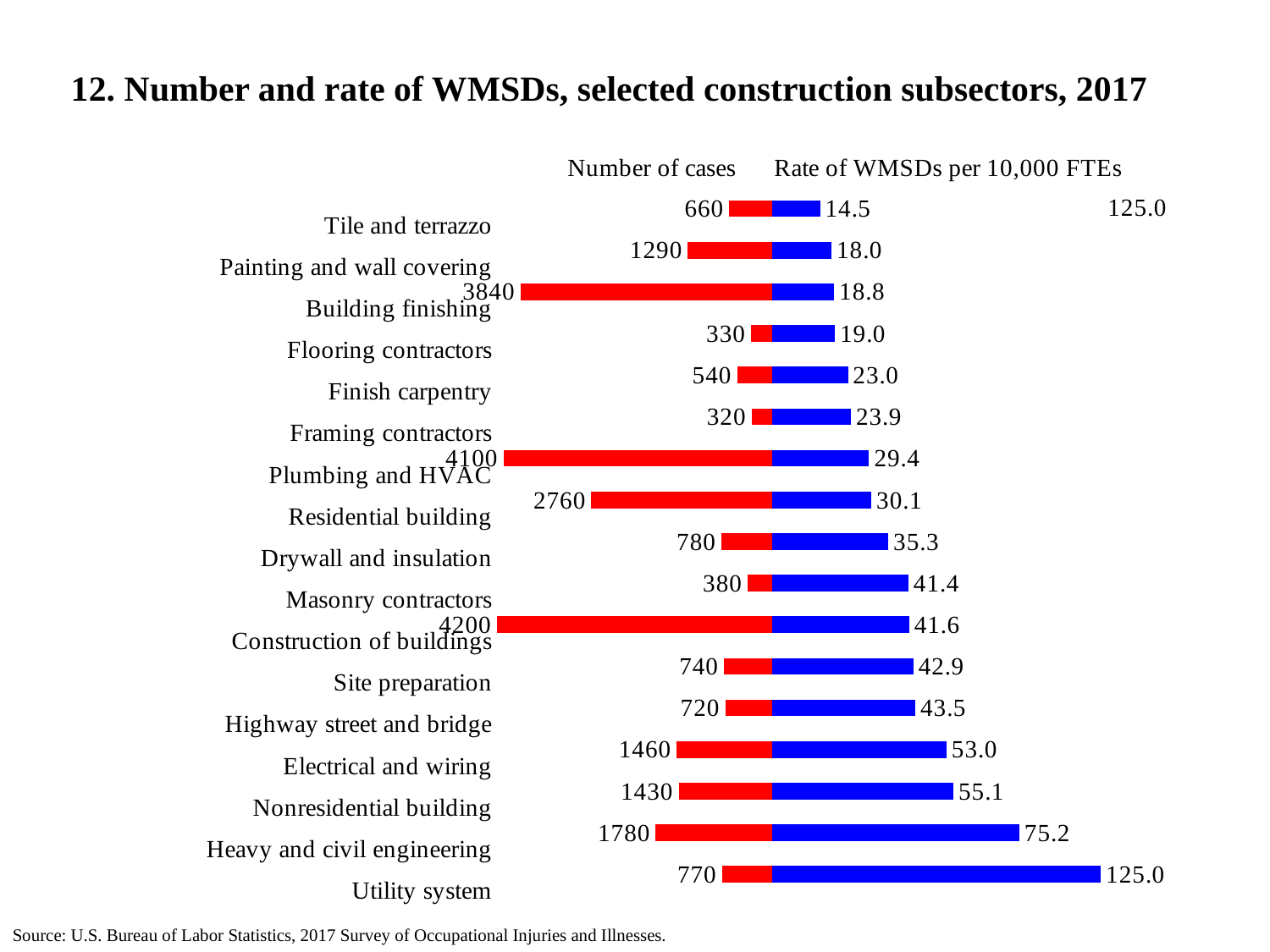
What is the rate of WMSDs per 10,000 FTEs for Heavy and civil engineering? 75.2 How many data series does the chart show? 2 Which subsector has the highest rate of WMSDs per 10,000 FTEs? Utility system What is the number of cases for Utility system? 770 What is the difference in number of cases between Construction of buildings and Building finishing? 360 How many construction subsectors are shown in the chart? 17 What is the rate of WMSDs per 10,000 FTEs for Tile and terrazzo? 14.5 Which subsector has the highest number of cases? Construction of buildings Which subsector has the lowest number of cases? Framing contractors Which has a higher rate of WMSDs per 10,000 FTEs, Electrical and wiring or Nonresidential building? Nonresidential building What type of chart is shown on the slide? Bar chart What is the number of cases for Plumbing and HVAC? 4100